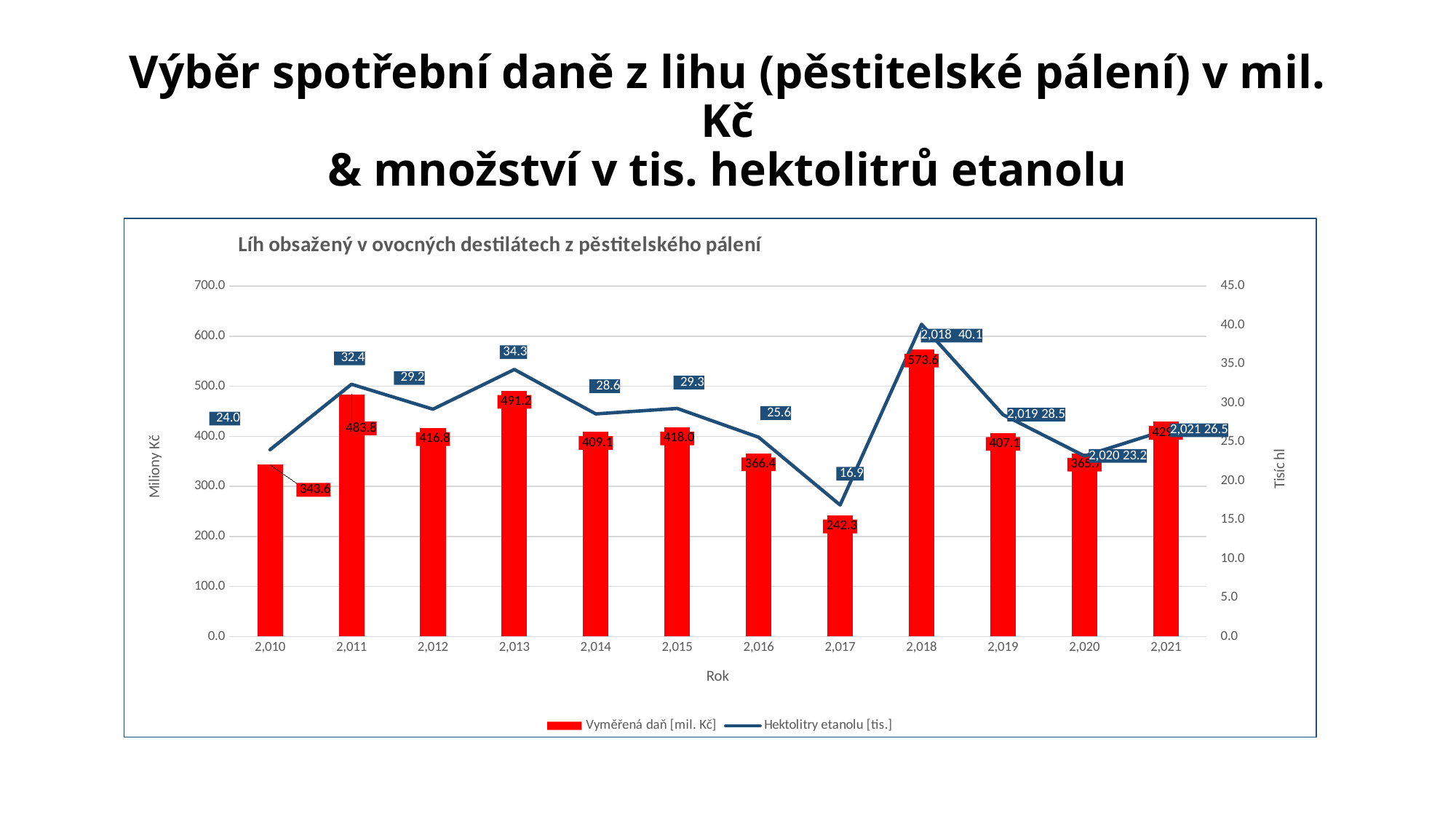
What kind of chart is shown on the slide? Combined bar and line chart What is the value of Vyměřená daň [mil. Kč] for 2,018? 573.6 Is the Vyměřená daň [mil. Kč] value for 2,016 greater or less than 400.0? less Which year has the highest value of Hektolitry etanolu [tis.]? 2,018 What is the value of Hektolitry etanolu [tis.] for 2,017? 16.9 What is the label of the left vertical axis of the chart? Miliony Kč Which year has the lowest value of Vyměřená daň [mil. Kč]? 2,017 How many series does the chart legend list? 2 How many years are shown on the x axis of the chart? 12 Which year has the larger Vyměřená daň [mil. Kč] value, 2,011 or 2,012? 2,011 What is the value of Vyměřená daň [mil. Kč] for 2,013? 491.2 What is the difference between the Vyměřená daň [mil. Kč] values for 2,018 and 2,017? 331.3